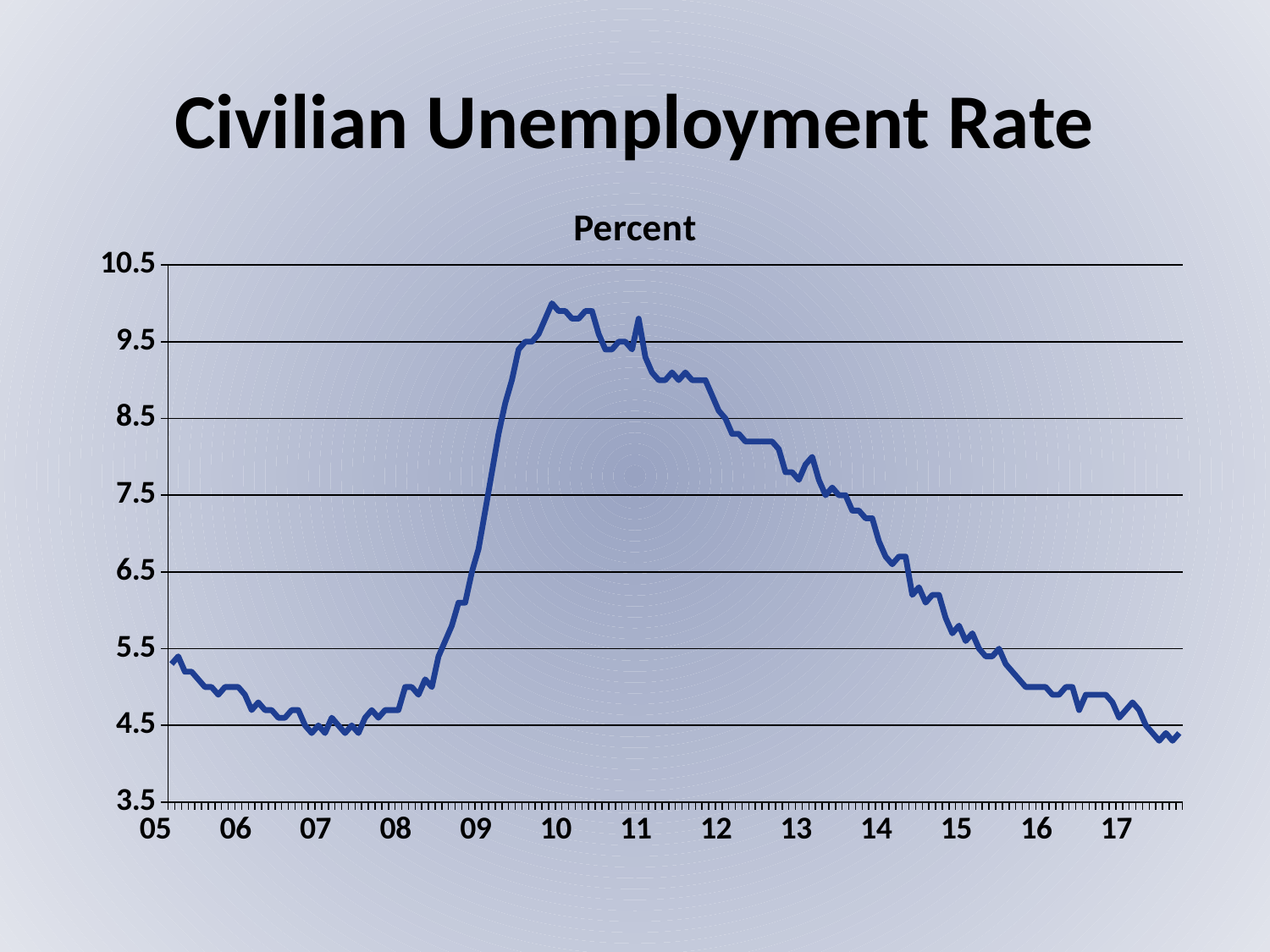
Is the value at the 15 tick greater or less than 6.5? less Is the value at the 16 tick greater or less than 5.5? less Is the value at the 11 tick greater or less than 8.5? greater What unit label is shown above the chart's plot area? Percent Which is higher, the unemployment rate at the 06 tick or at the 12 tick? 12 How many lines (series) are plotted on the chart? 1 What kind of chart is shown on the slide? line chart What is the title of the chart? Civilian Unemployment Rate Does the unemployment rate rise or fall between the 10 tick and the 17 tick? fall How many year labels appear along the x axis? 13